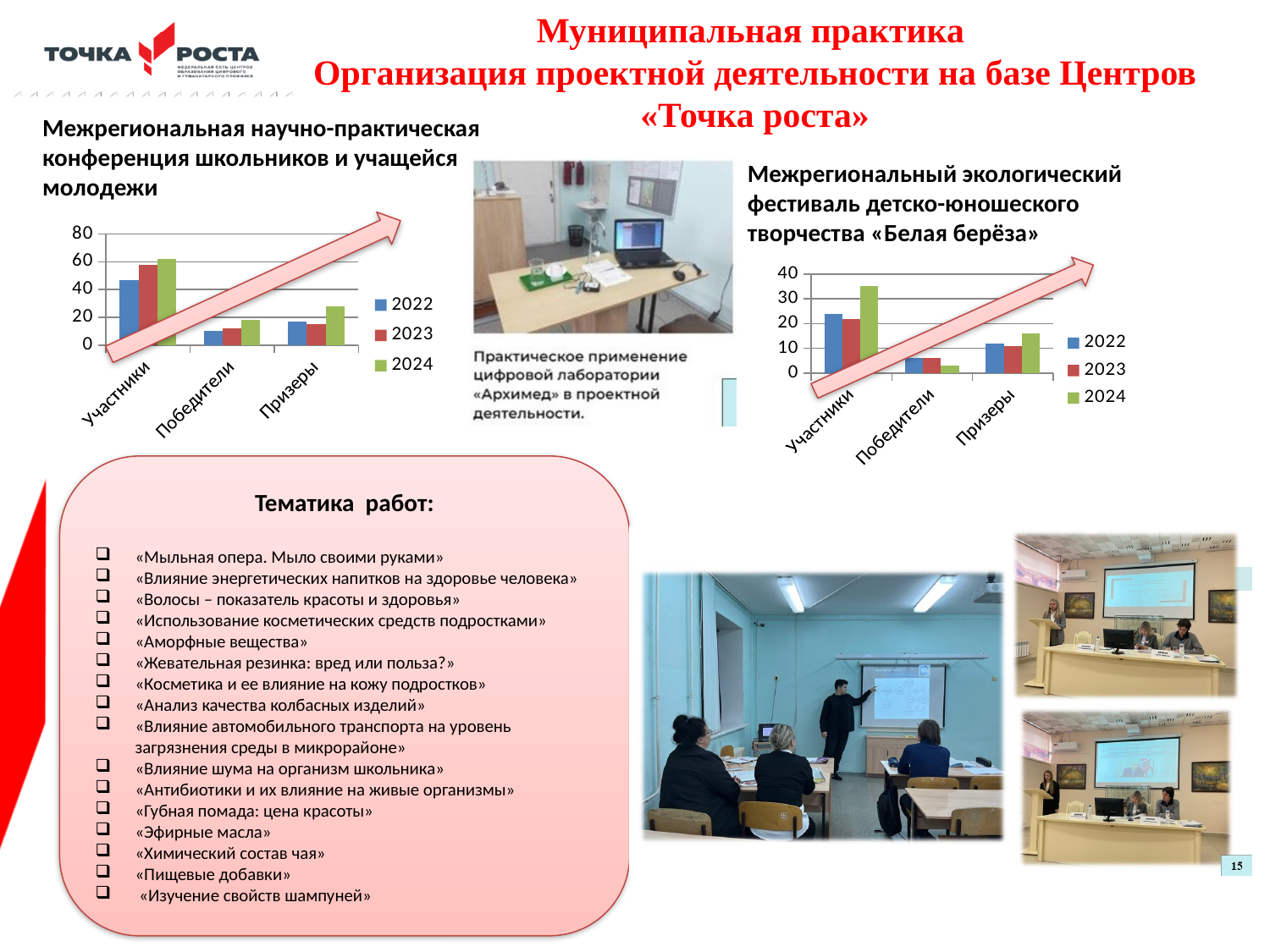
What kind of chart is used for the «Межрегиональная научно-практическая конференция» data on the left of the slide? bar chart In the right chart («Белая берёза»), which is larger: Призеры in 2024 or Победители in 2024? Призеры in 2024 In the left chart (научно-практическая конференция), which is larger: Призеры in 2024 or Призеры in 2023? Призеры in 2024 What colour represents the 2023 series in the right chart («Белая берёза»)? red In the left chart (научно-практическая конференция), which year has the highest value for Участники? 2024 In the right chart («Белая берёза»), is the value for Участники in 2024 greater or less than 30? greater In the right chart («Белая берёза»), which year has the highest value for Участники? 2024 How many categories are shown on the x axis of the left chart (научно-практическая конференция)? 3 In the left chart (научно-практическая конференция), is the value for Победители in 2022 greater or less than 20? less In the right chart («Белая берёза»), which year has the lowest value for Победители? 2024 How many series does the legend of the left chart (научно-практическая конференция) list? 3